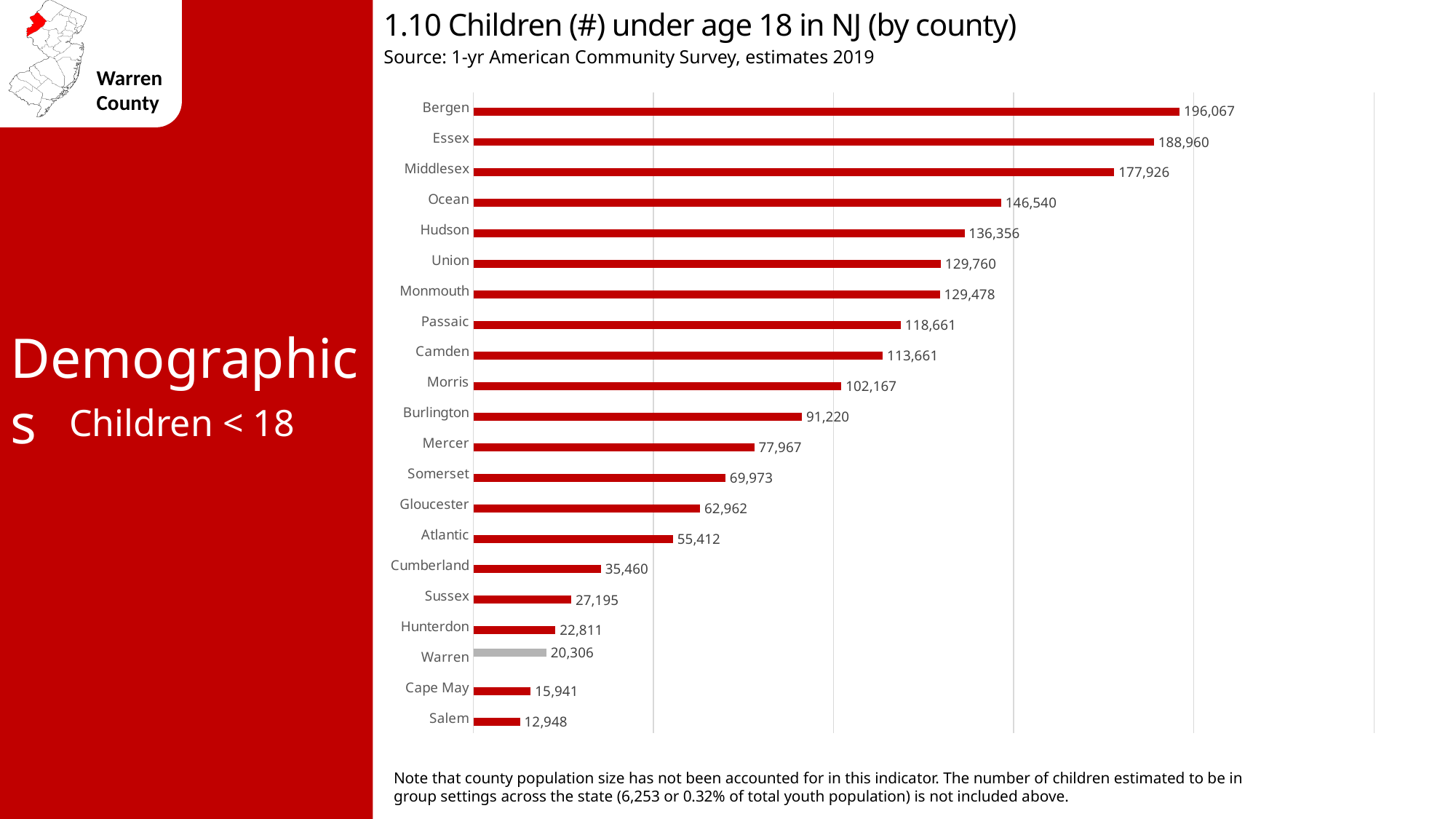
Which county has more children under 18, Sussex or Cumberland? Cumberland Which county has more children under 18, Ocean or Hudson? Ocean What type of chart is used to show children under age 18 by county? Bar chart What is the number of children under age 18 in Bergen County? 196,067 Which county has the lowest number of children under age 18? Salem How many counties are shown in the chart? 21 How many more children under 18 does Warren County have than Cape May County? 4,365 What is the number of children under age 18 in Morris County? 102,167 What is the difference between the number of children under 18 in Bergen and Essex counties? 7,107 What is the number of children under age 18 in Warren County? 20,306 Which county has the highest number of children under age 18? Bergen Which county's bar is shown in grey instead of red? Warren